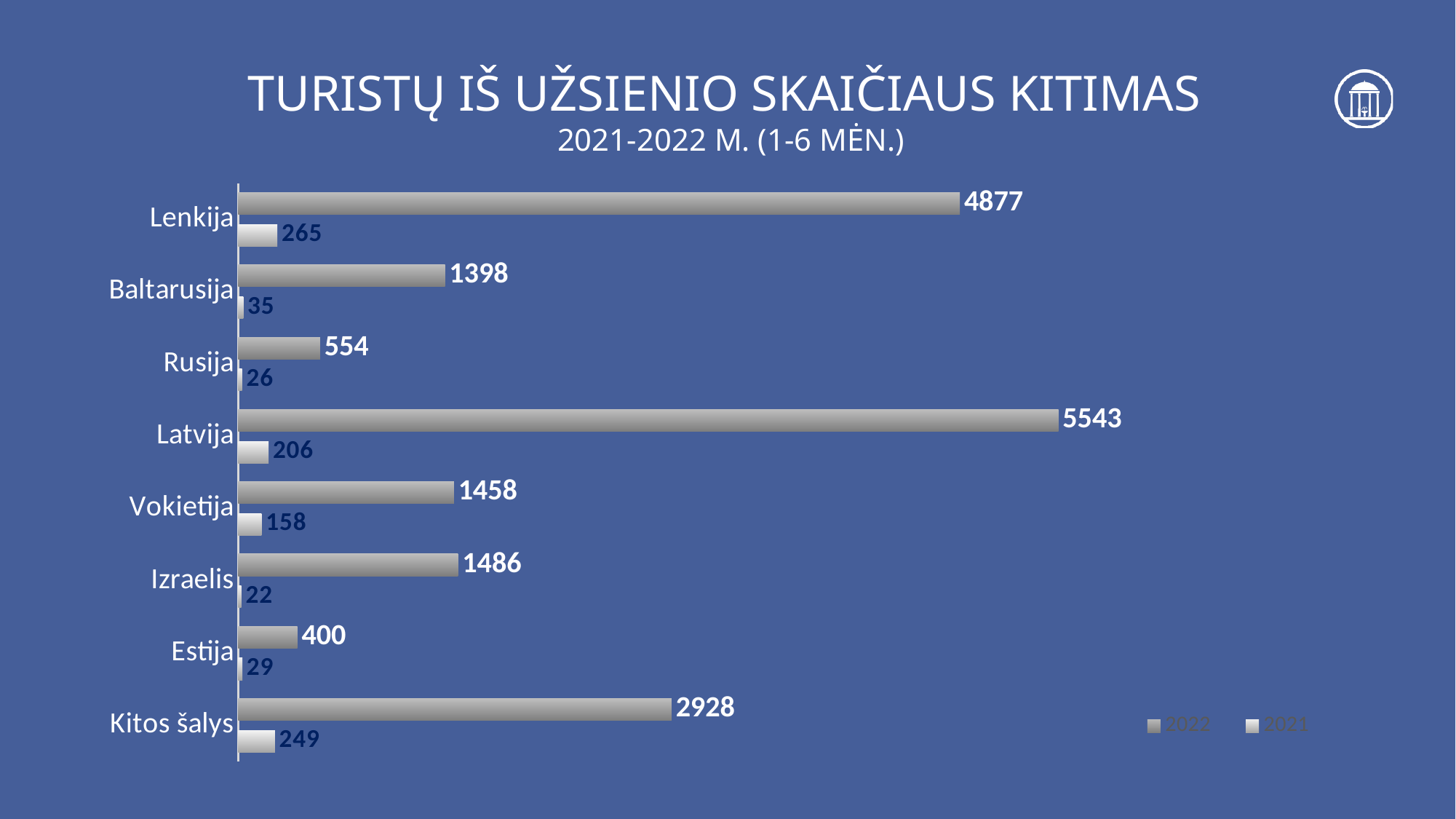
What is the 2021 value for Vokietija? 158 What is the difference between the 2022 values for Baltarusija and Rusija? 844 What is the difference between the 2022 and 2021 values for Lenkija? 4612 Which category has the lowest 2021 value? Izraelis Which category has the highest 2022 value? Latvija What is the 2022 value for Latvija? 5543 Which is larger, the 2022 value for Izraelis or the 2022 value for Vokietija? Izraelis How many series does the legend list? 2 What is the title of the chart? TURISTŲ IŠ UŽSIENIO SKAIČIAUS KITIMAS 2021-2022 M. (1-6 MĖN.) How many categories are shown on the chart? 8 What kind of chart is shown on the slide? Bar chart What is the 2022 value for Kitos šalys? 2928